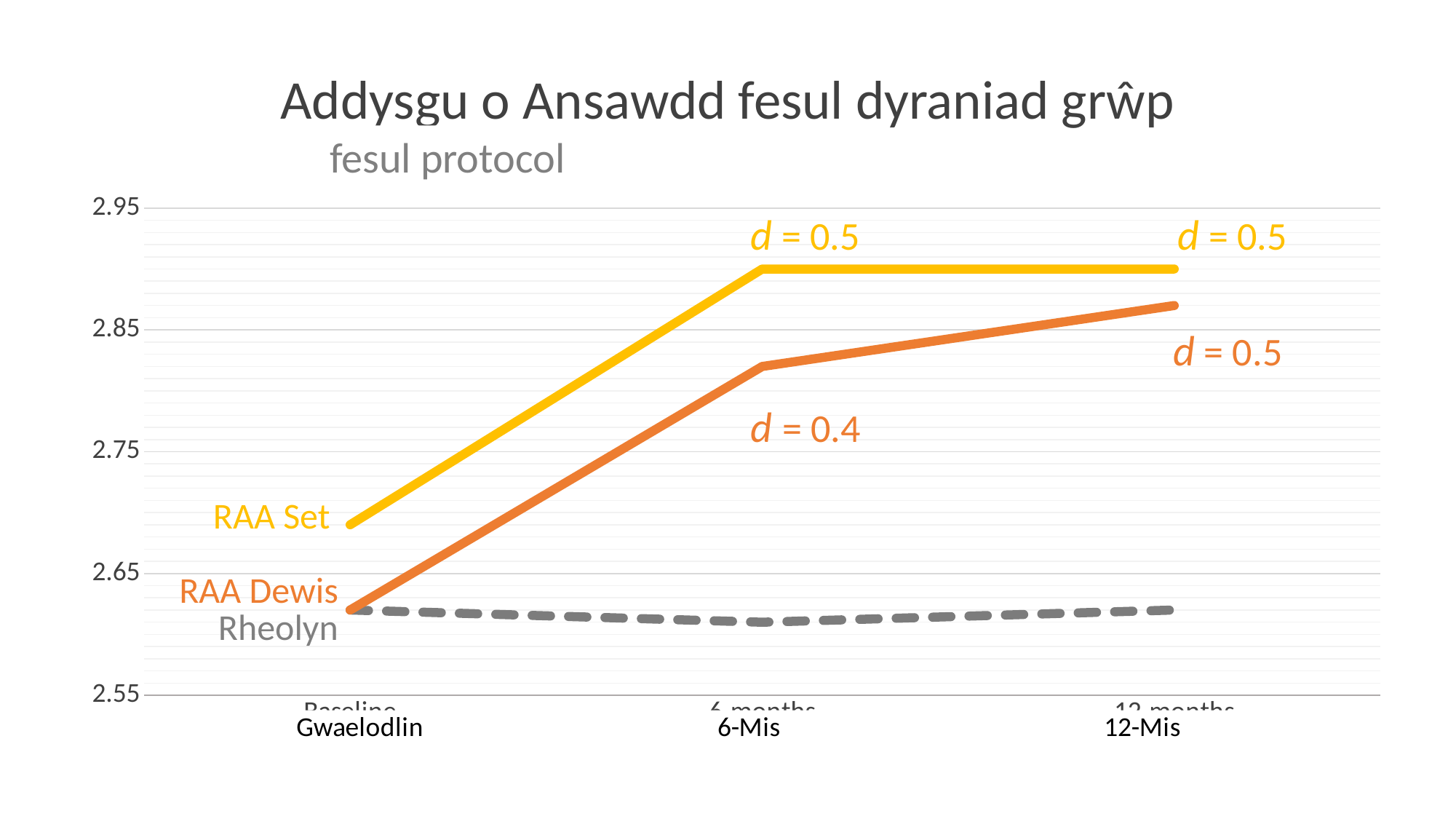
What effect size (d) is annotated for RAA Dewis at 6-Mis? d = 0.4 Does the RAA Set line rise or fall from Gwaelodlin to 6-Mis? rises What kind of chart is shown on the slide? line chart How many series are plotted on the chart? 3 At 12-Mis, which is larger: RAA Dewis or Rheolyn? RAA Dewis Is the value for RAA Set at 6-Mis greater or less than 2.85? greater Is the value for RAA Set at Gwaelodlin greater or less than 2.65? greater Which series has the lowest value at 6-Mis? Rheolyn Is the value for RAA Dewis at Gwaelodlin greater or less than 2.65? less What is the title of the chart? Addysgu o Ansawdd fesul dyraniad grŵp How many time points are shown on the x axis? 3 Which series has the highest value at 12-Mis? RAA Set